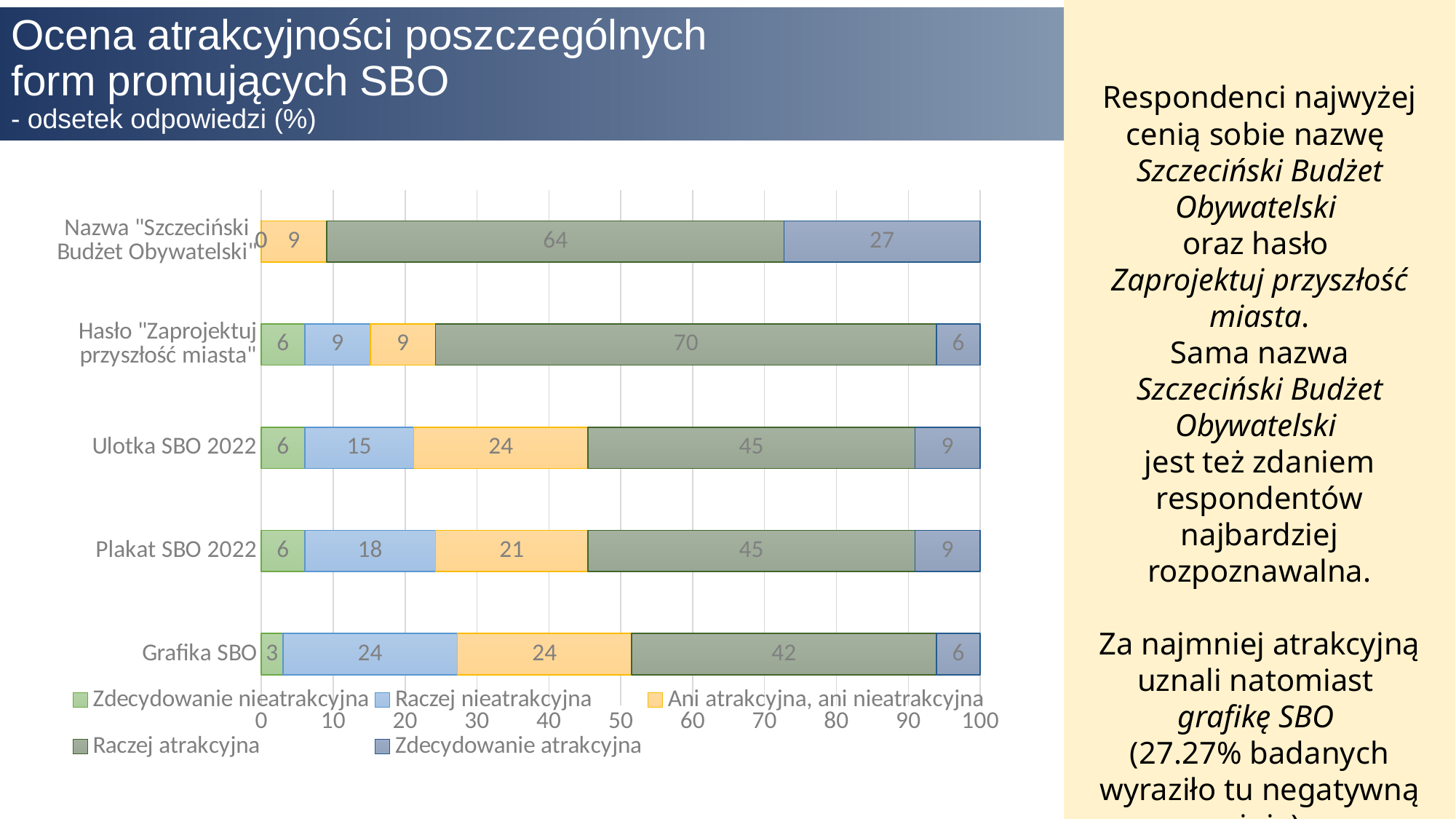
What is the value of "Raczej nieatrakcyjna" for Grafika SBO? 24 What is the value of "Zdecydowanie atrakcyjna" for Nazwa "Szczeciński Budżet Obywatelski"? 27 How many series does the legend list? 5 What is the value of "Ani atrakcyjna, ani nieatrakcyjna" for Plakat SBO 2022? 21 Which category has the highest value for "Zdecydowanie atrakcyjna"? Nazwa "Szczeciński Budżet Obywatelski" How many categories are plotted on the chart? 5 Which category has the lowest value for "Raczej atrakcyjna"? Grafika SBO What is the difference between the "Raczej nieatrakcyjna" values for Plakat SBO 2022 and Ulotka SBO 2022? 3 What is the value of "Raczej atrakcyjna" for Hasło "Zaprojektuj przyszłość miasta"? 70 Which is larger: the "Raczej atrakcyjna" value for Nazwa "Szczeciński Budżet Obywatelski" or for Ulotka SBO 2022? Nazwa "Szczeciński Budżet Obywatelski" What colour represents "Ani atrakcyjna, ani nieatrakcyjna" in the chart? orange What kind of chart is shown on the slide? stacked bar chart